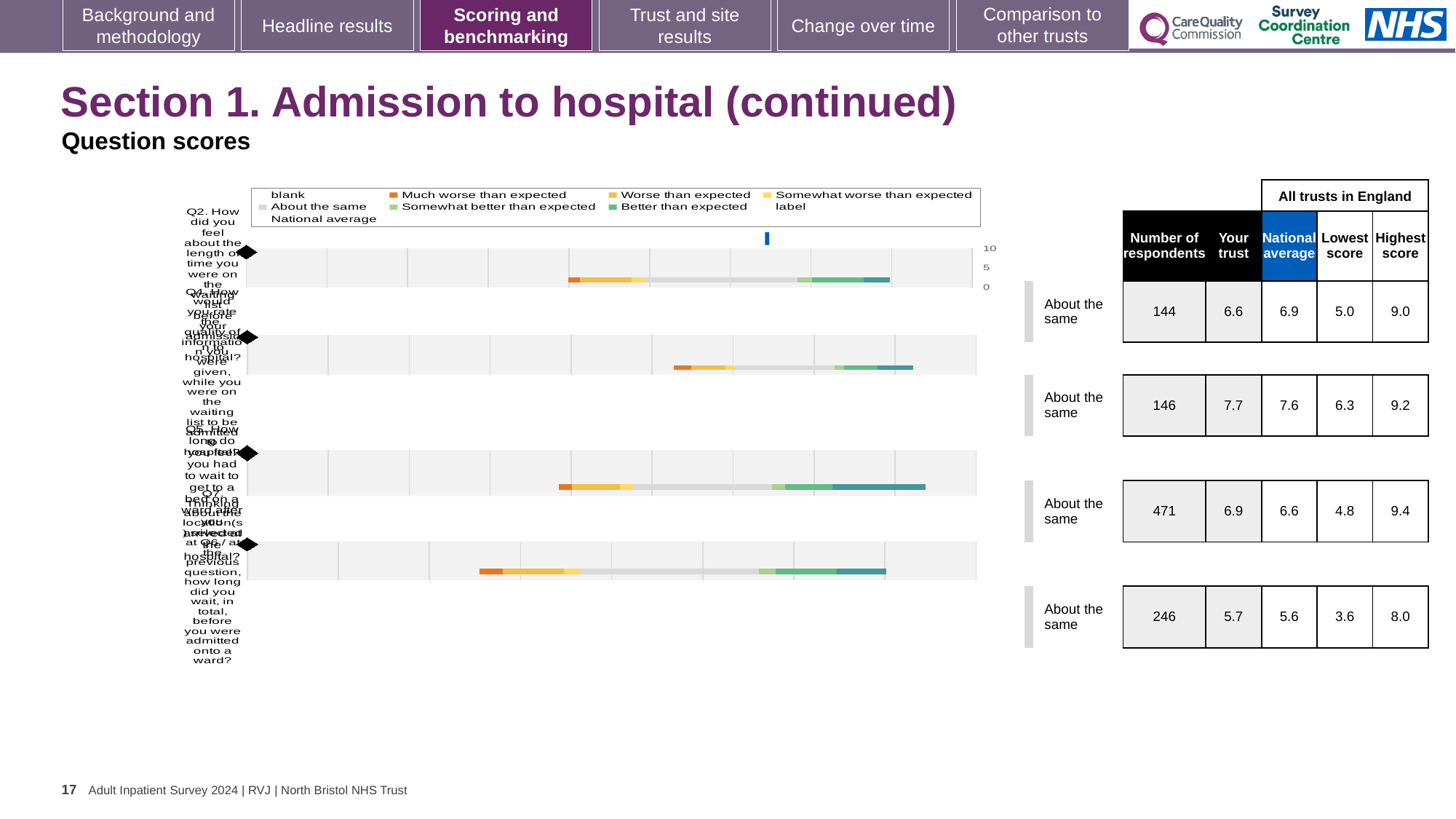
In the table beside the chart, what is the 'Your trust' score for the first row (Q2)? 6.6 What is the highest value shown on the chart's axis? 10 How many question rows are plotted in the chart? 4 What benchmark category is shown for every question row on the slide? About the same In the table beside the chart, is the 'Your trust' score for the third row (Q5) larger or smaller than its national average? larger In the table beside the chart, what is the national average for the fourth row (Q7)? 5.6 Which legend entry is shown in orange? Much worse than expected In the table beside the chart, which row has the lowest 'Lowest score' value? fourth row (Q7), 3.6 What kind of chart is shown on the slide? bar chart In the table beside the chart, what is the number of respondents for the third row (Q5)? 471 In the table beside the chart, what is the difference between the highest score and lowest score for the second row (Q4)? 2.9 In the table beside the chart, which row has the highest 'Your trust' score? second row (Q4), 7.7